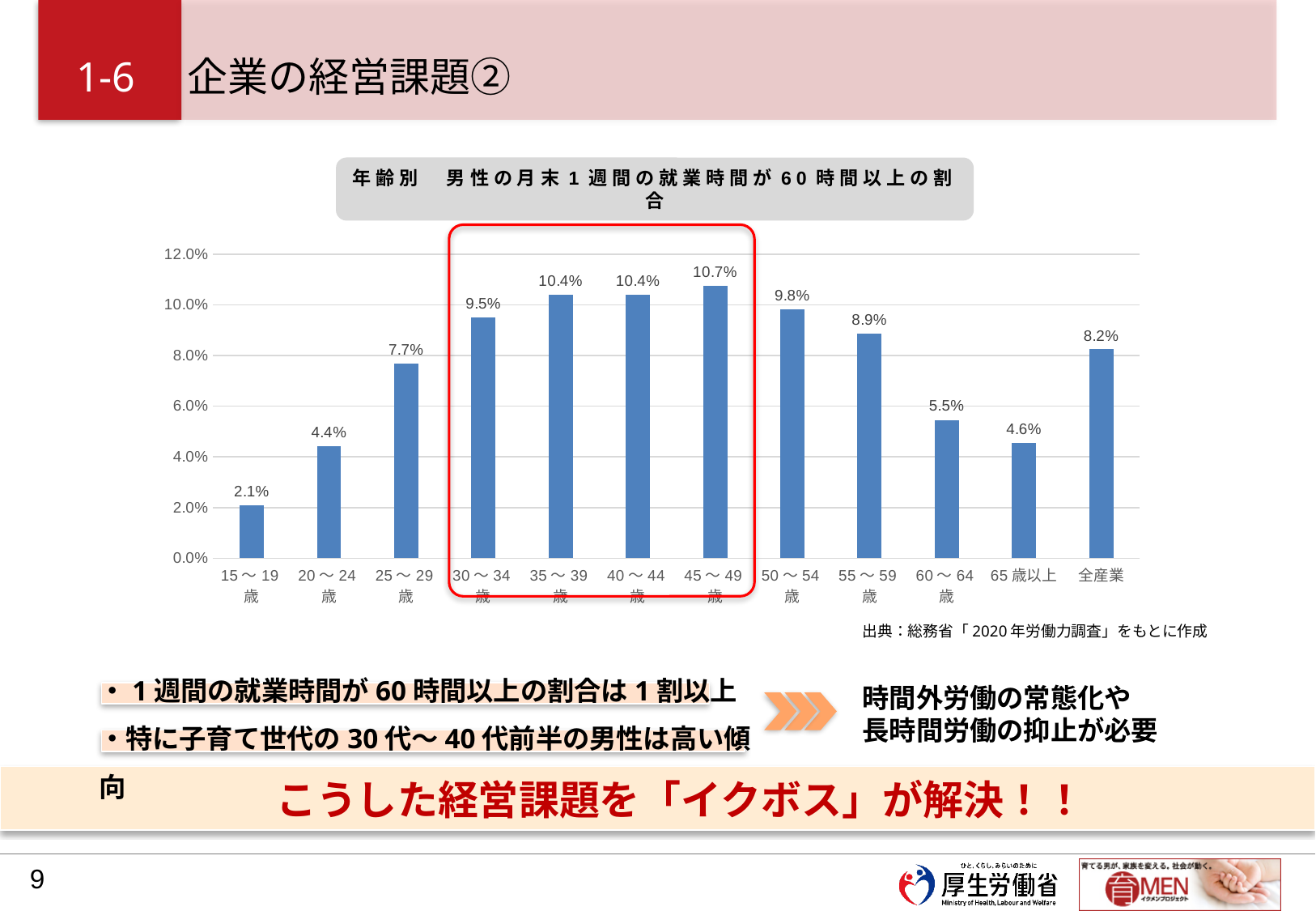
Is the value for 60～64歳 greater or less than 6.0%? less Do the values rise or fall from 15～19歳 to 45～49歳? rise Which age category has the highest value? 45～49歳 What is the value for 15～19歳? 2.1% Which is larger, the value for 25～29歳 or the value for 65歳以上? 25～29歳 Which age category has the lowest value? 15～19歳 What kind of chart is shown on the slide? bar chart How many categories are shown on the x axis? 12 What is the title of the chart? 年齢別 男性の月末1週間の就業時間が60時間以上の割合 What is the difference between the values for 50～54歳 and 55～59歳? 0.9% What is the value for 45～49歳? 10.7% What is the value for 全産業? 8.2%